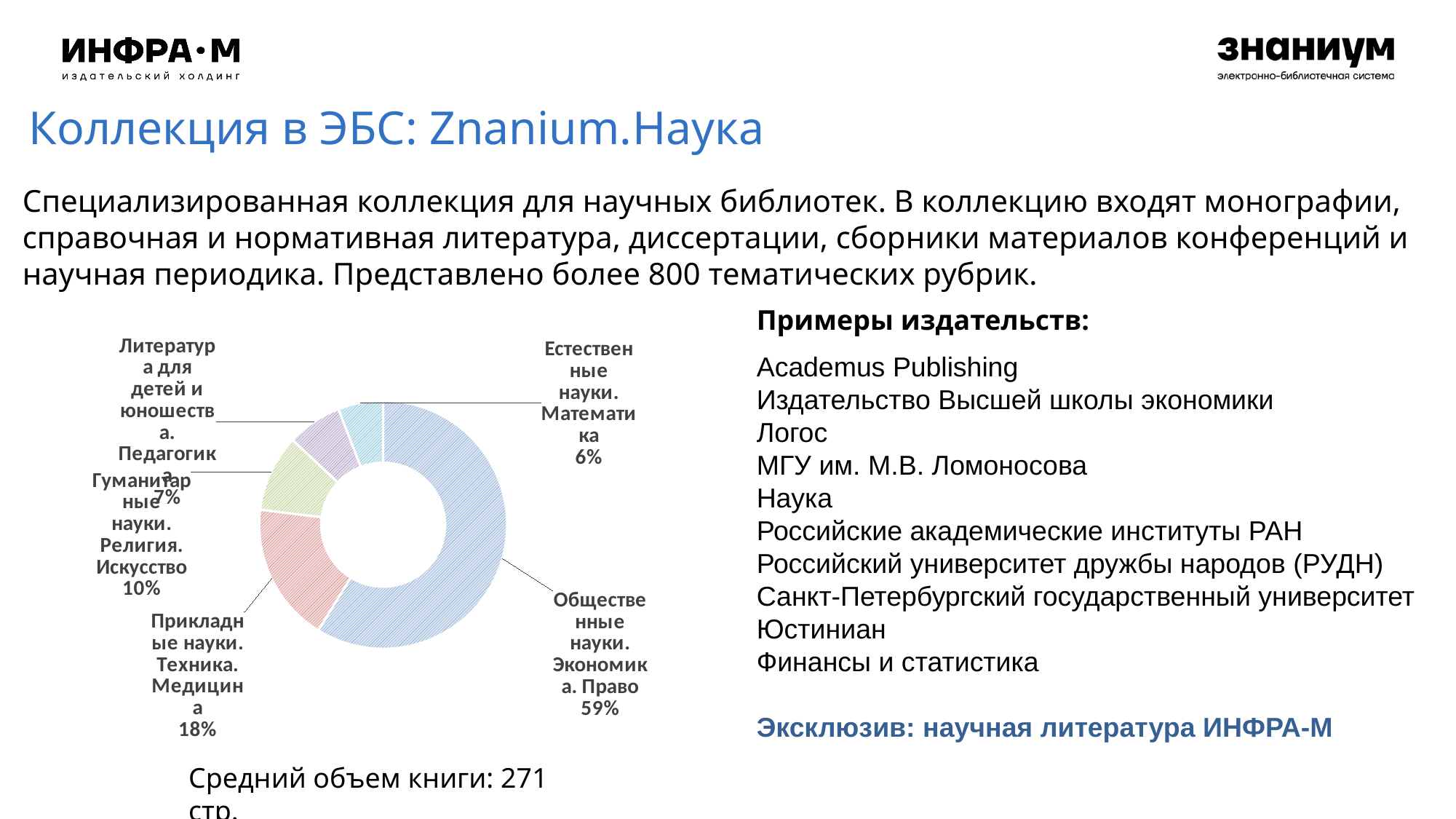
What share of the collection is Педагогика? 7% What is the difference in percentage points between Общественные науки. Экономика. Право and Прикладные науки. Техника. Медицина? 41 percentage points What is the average book length stated below the chart? 271 стр. Is the share for Общественные науки. Экономика. Право greater or less than 50%? greater How many slices does the chart have? 5 What share of the collection is Естественные науки. Математика? 6% What share of the collection is Общественные науки. Экономика. Право? 59% What kind of chart is shown on the slide? doughnut (pie) chart Which is larger: Прикладные науки. Техника. Медицина or Гуманитарные науки. Религия. Искусство? Прикладные науки. Техника. Медицина What share of the collection is Прикладные науки. Техника. Медицина? 18% What share of the collection is Гуманитарные науки. Религия. Искусство? 10% Which category has the largest share of the chart? Общественные науки. Экономика. Право